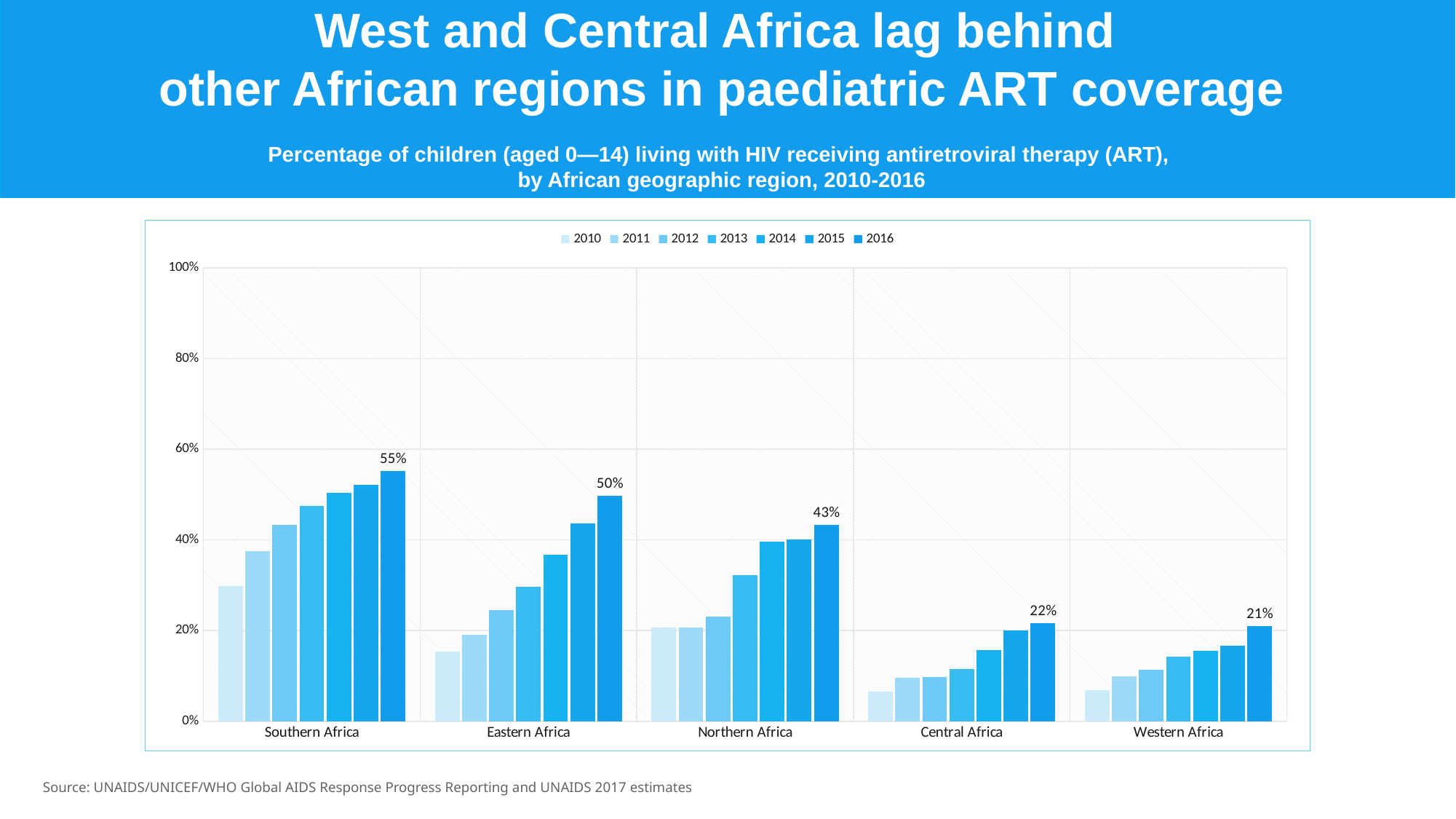
What is the 2016 value for Southern Africa? 55% What is the 2016 value for Central Africa? 22% What is the 2016 value for Eastern Africa? 50% What kind of chart is shown? bar chart Which is larger, the 2016 value for Eastern Africa or for Northern Africa? Eastern Africa How many regions are shown on the x axis? 5 How many series does the legend list? 7 What is the 2016 value for Northern Africa? 43% Which region has the lowest 2016 value? Western Africa What is the difference between the 2016 values for Southern Africa and Western Africa? 34% Is the 2010 value for Southern Africa greater or less than 20%? greater Which region has the highest 2016 value? Southern Africa